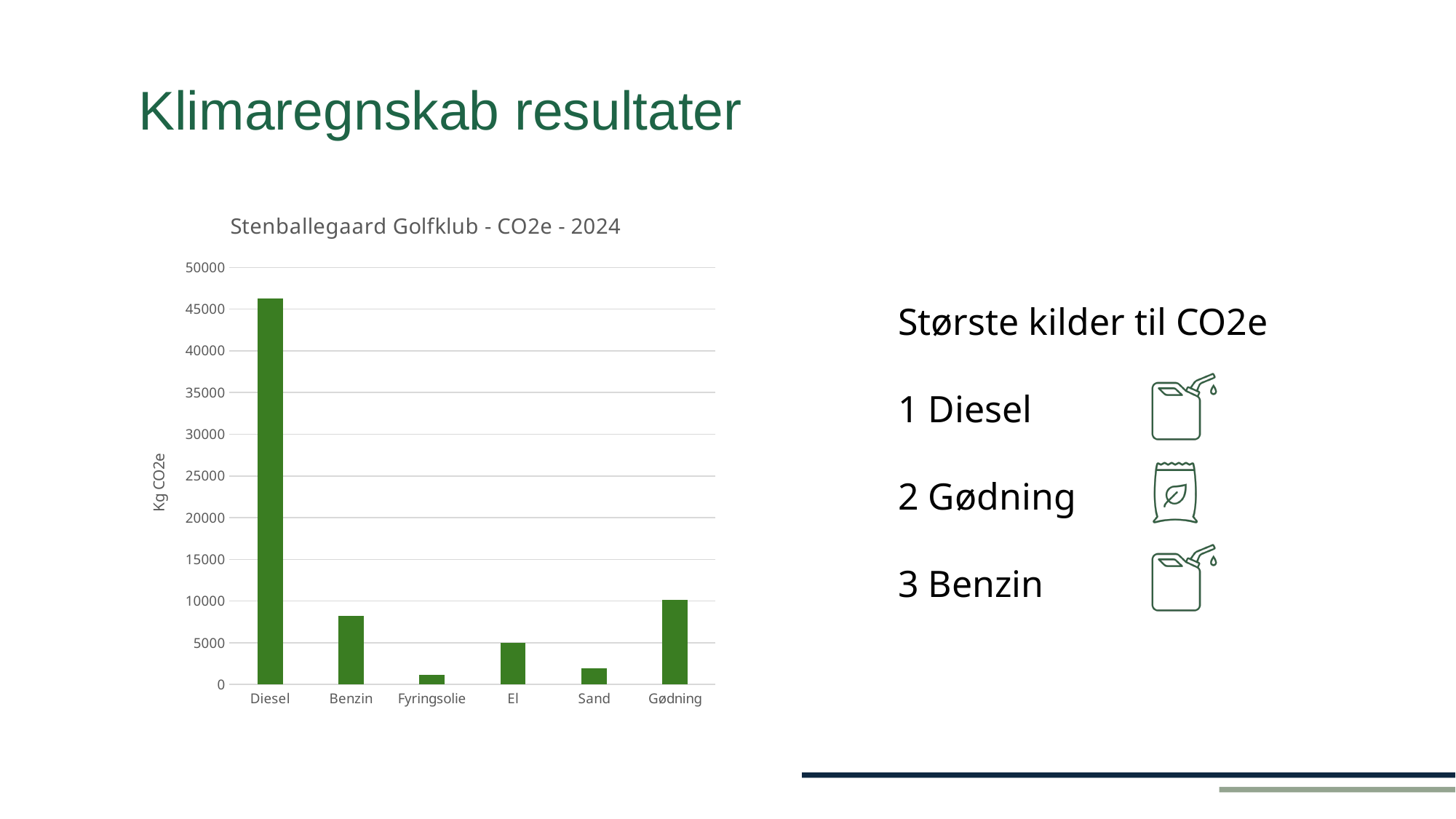
What is the title of the chart? Stenballegaard Golfklub - CO2e - 2024 Which has a larger value, Gødning or Benzin? Gødning What is the label on the vertical axis of the chart? Kg CO2e How many categories are shown on the x axis of the chart? 6 Is the value for Gødning greater or less than 5000? greater Which category has the lowest value in the chart? Fyringsolie Which has a larger value, Sand or El? El Is the value for Fyringsolie greater or less than 5000? less Is the value for Diesel greater or less than 40000? greater What kind of chart is shown on the slide? bar chart Which category has the highest value in the chart? Diesel